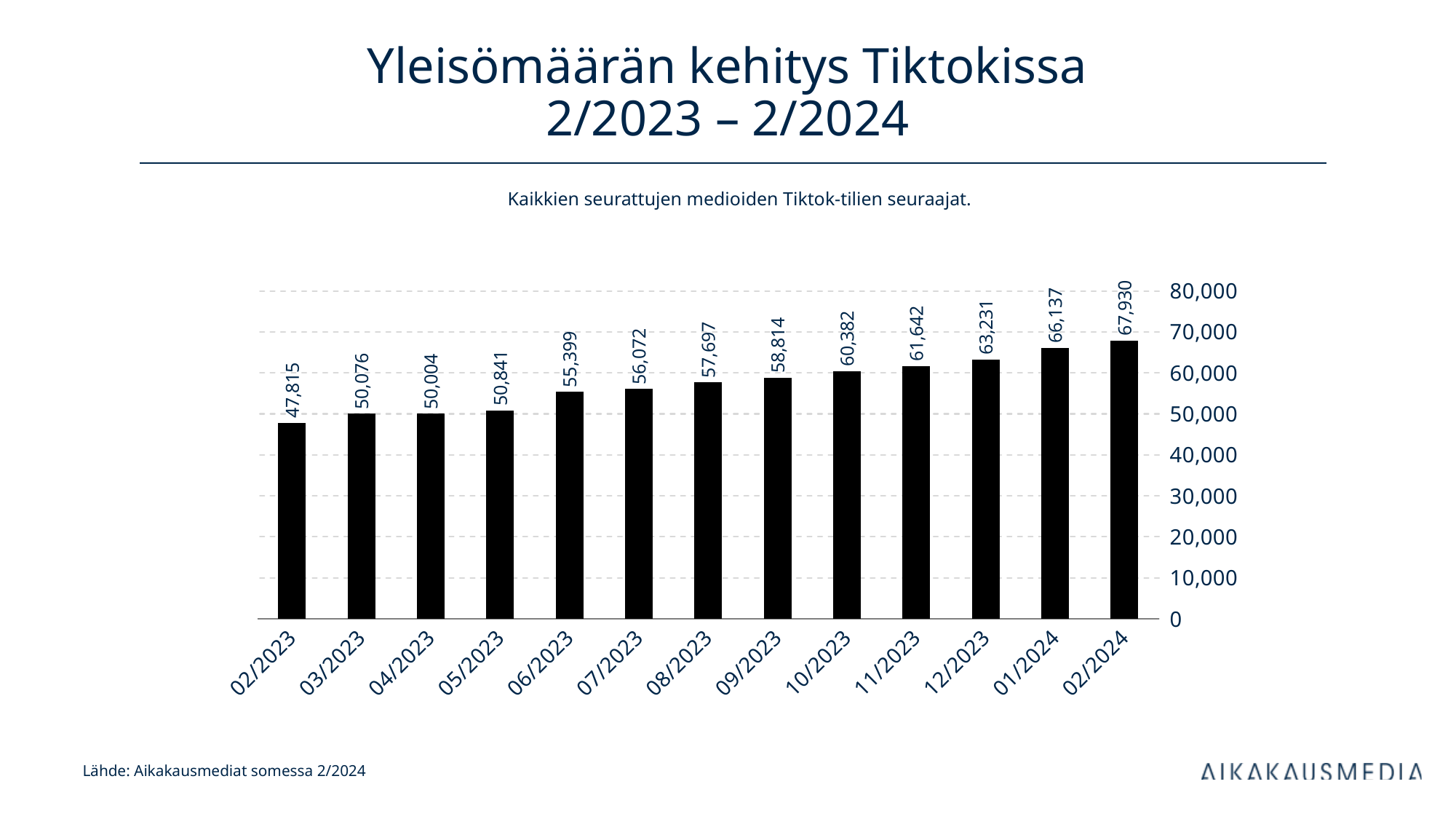
What is the value for 02/2024? 67,930 Which month has the lowest value? 02/2023 Which is larger, the value for 03/2023 or the value for 04/2023? 03/2023 Which month has the highest value? 02/2024 What is the difference between the values for 01/2024 and 12/2023? 2,906 What is the value for 02/2023? 47,815 Do the values generally rise or fall from 02/2023 to 02/2024? rise Is the value for 10/2023 greater or less than 50,000? greater How many months are shown on the x axis? 13 What is the value for 07/2023? 56,072 What kind of chart is shown on the slide? bar chart What is the difference between the values for 02/2024 and 02/2023? 20,115